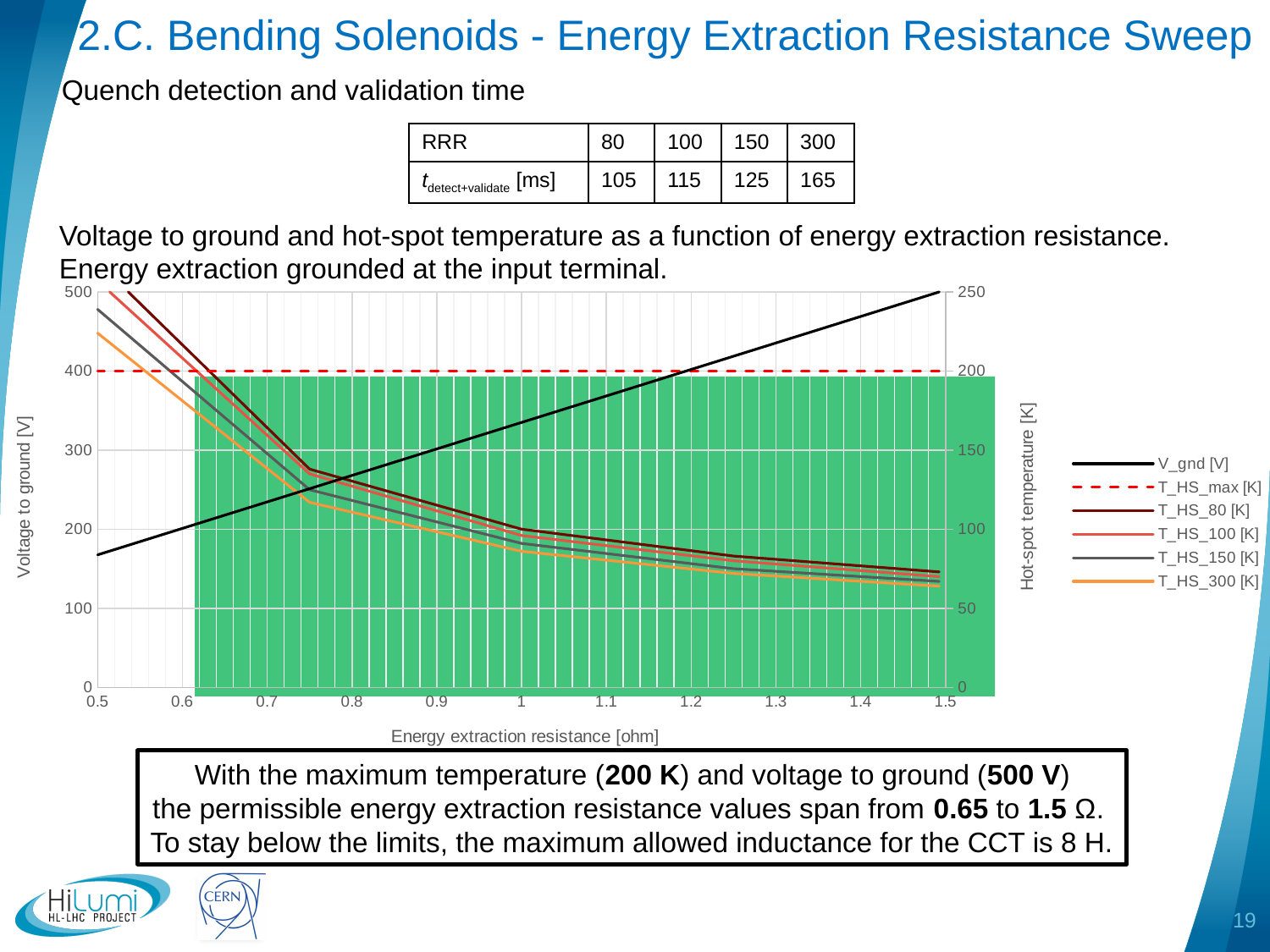
Is the value of V_gnd [V] at 0.5 ohm greater or less than 200? less What voltage to ground does the V_gnd [V] line reach at 1.5 ohm? 500 What is the label of the x axis of the chart? Energy extraction resistance [ohm] Is the hot-spot temperature of T_HS_80 [K] at 0.6 ohm greater or less than 200? greater Does the V_gnd [V] series rise or fall as the energy extraction resistance increases? rise Among the T_HS_80, T_HS_100, T_HS_150 and T_HS_300 series, which has the lowest hot-spot temperature at 0.7 ohm? T_HS_300 [K] At what constant hot-spot temperature is the dashed T_HS_max [K] line drawn? 200 Is the hot-spot temperature of T_HS_300 [K] at 1.5 ohm greater or less than 100? less Does the T_HS_80 [K] series rise or fall as the energy extraction resistance increases? fall What type of chart is shown on the slide? line chart How many series does the chart legend list? 6 At 1.0 ohm, which series has the higher hot-spot temperature, T_HS_80 [K] or T_HS_300 [K]? T_HS_80 [K]